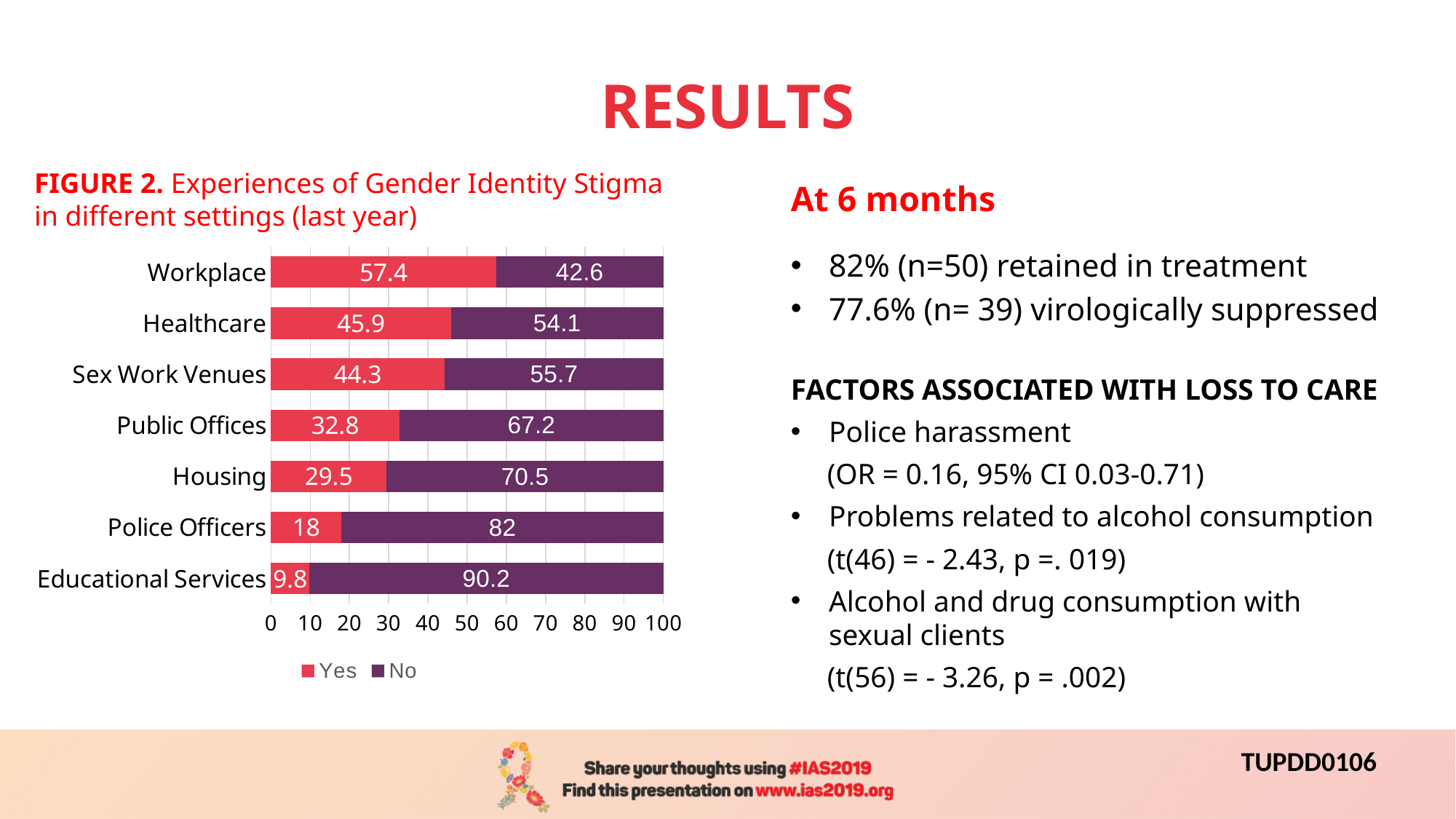
What is the 'Yes' value for Workplace? 57.4 What is the 'No' value for Housing? 70.5 What kind of chart is shown? Stacked bar chart Which setting has the highest 'Yes' value? Workplace What is the total of the stacked bar for Public Offices? 100 How many series does the legend list? 2 What is the 'Yes' value for Educational Services? 9.8 Which colour represents the 'No' series in the chart? Purple Which setting has the lowest 'Yes' value? Educational Services Which is larger: the 'Yes' value for Healthcare or the 'Yes' value for Sex Work Venues? Healthcare What is the difference between the 'No' value for Police Officers and the 'No' value for Public Offices? 14.8 How many settings are shown on the chart? 7